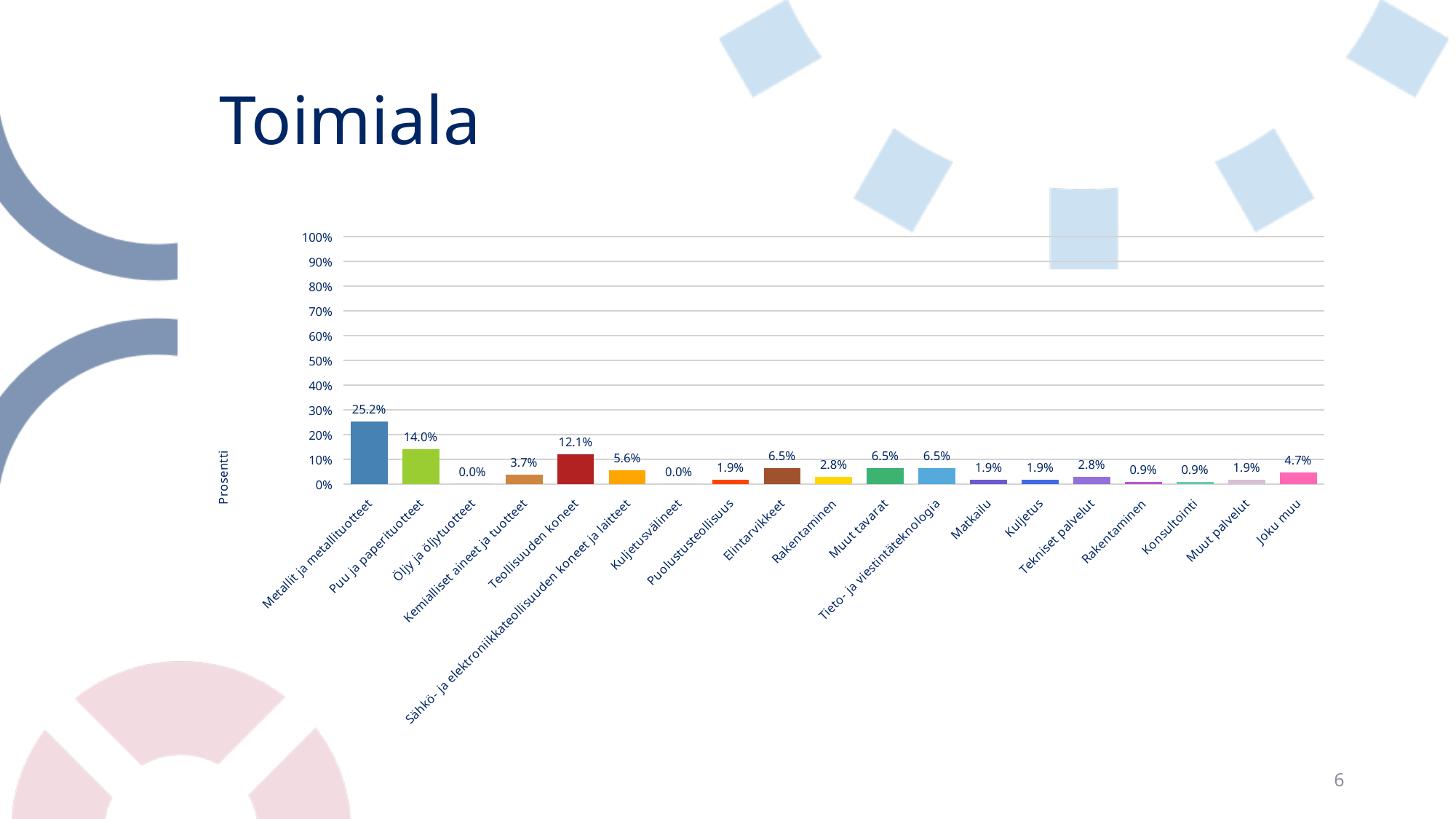
What is the value for Teollisuuden koneet? 12.1% Is the value for Puu ja paperituotteet greater or less than 10%? greater How many categories are shown on the x axis? 19 What kind of chart is shown on the slide? bar chart What is the value for Kemialliset aineet ja tuotteet? 3.7% Which is larger, Elintarvikkeet or Sähkö- ja elektroniikkateollisuuden koneet ja laitteet? Elintarvikkeet What is the label of the vertical axis? Prosentti What is the value for Joku muu? 4.7% What is the title of the slide containing the chart? Toimiala Which category has the highest value? Metallit ja metallituotteet What is the value for Metallit ja metallituotteet? 25.2% What is the difference between Metallit ja metallituotteet and Puu ja paperituotteet? 11.2%